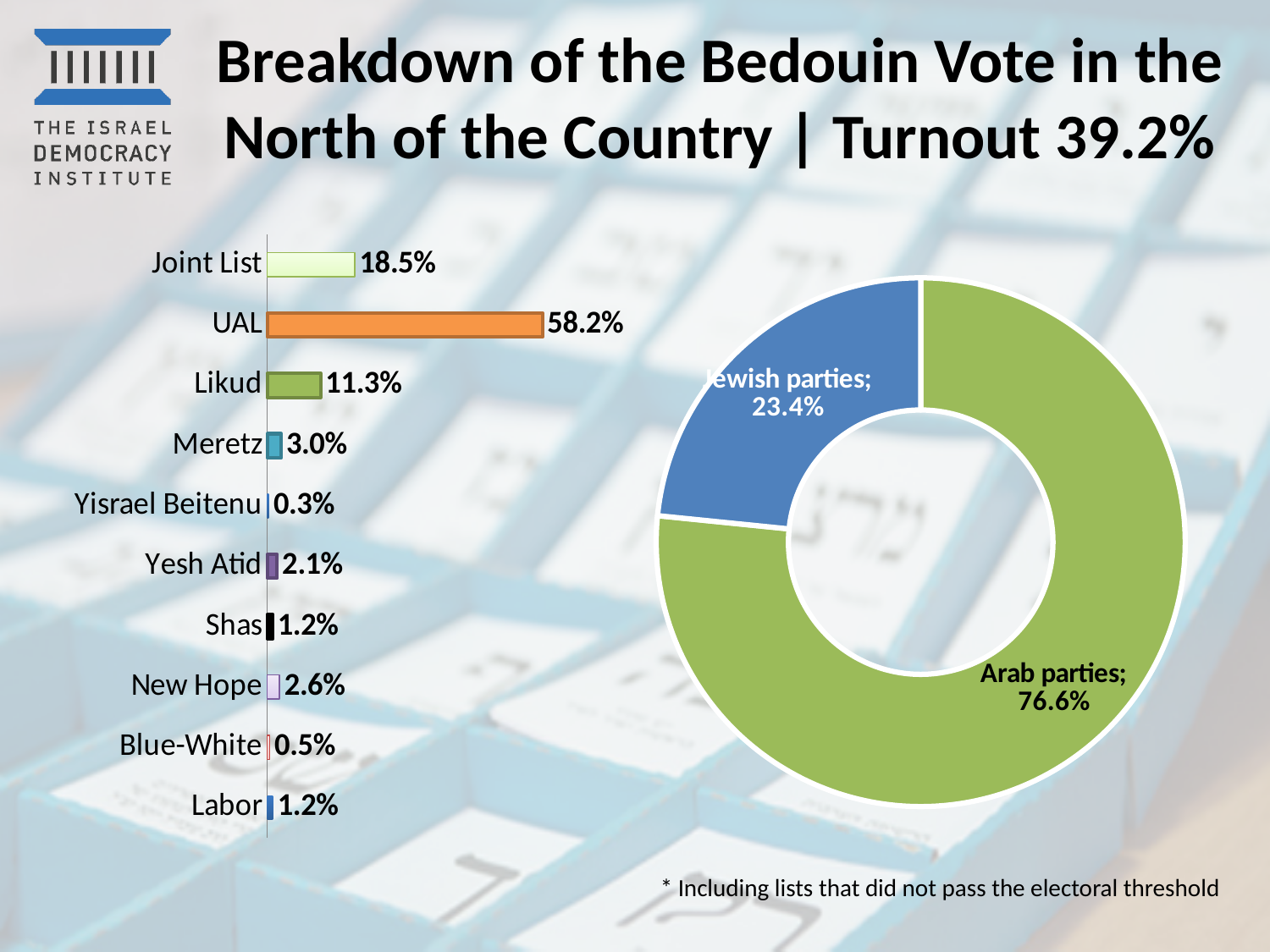
In the donut chart on the right, what is the value for Jewish parties? 23.4% In the bar chart on the left, which party has the lowest value? Yisrael Beitenu In the bar chart on the left, which party has the highest value? UAL In the bar chart on the left, what is the value for Yisrael Beitenu? 0.3% In the bar chart on the left, which is larger, the value for Meretz or the value for New Hope? Meretz What kind of chart is on the left side of the slide? Bar chart In the bar chart on the left, what is the value for Likud? 11.3% In the donut chart on the right, what share do Arab parties have? 76.6% How many parties are shown in the bar chart on the left? 10 What turnout figure is given in the slide title? 39.2% In the bar chart on the left, what is the difference between the values for UAL and Joint List? 39.7% In the bar chart on the left, what is the value for UAL? 58.2%